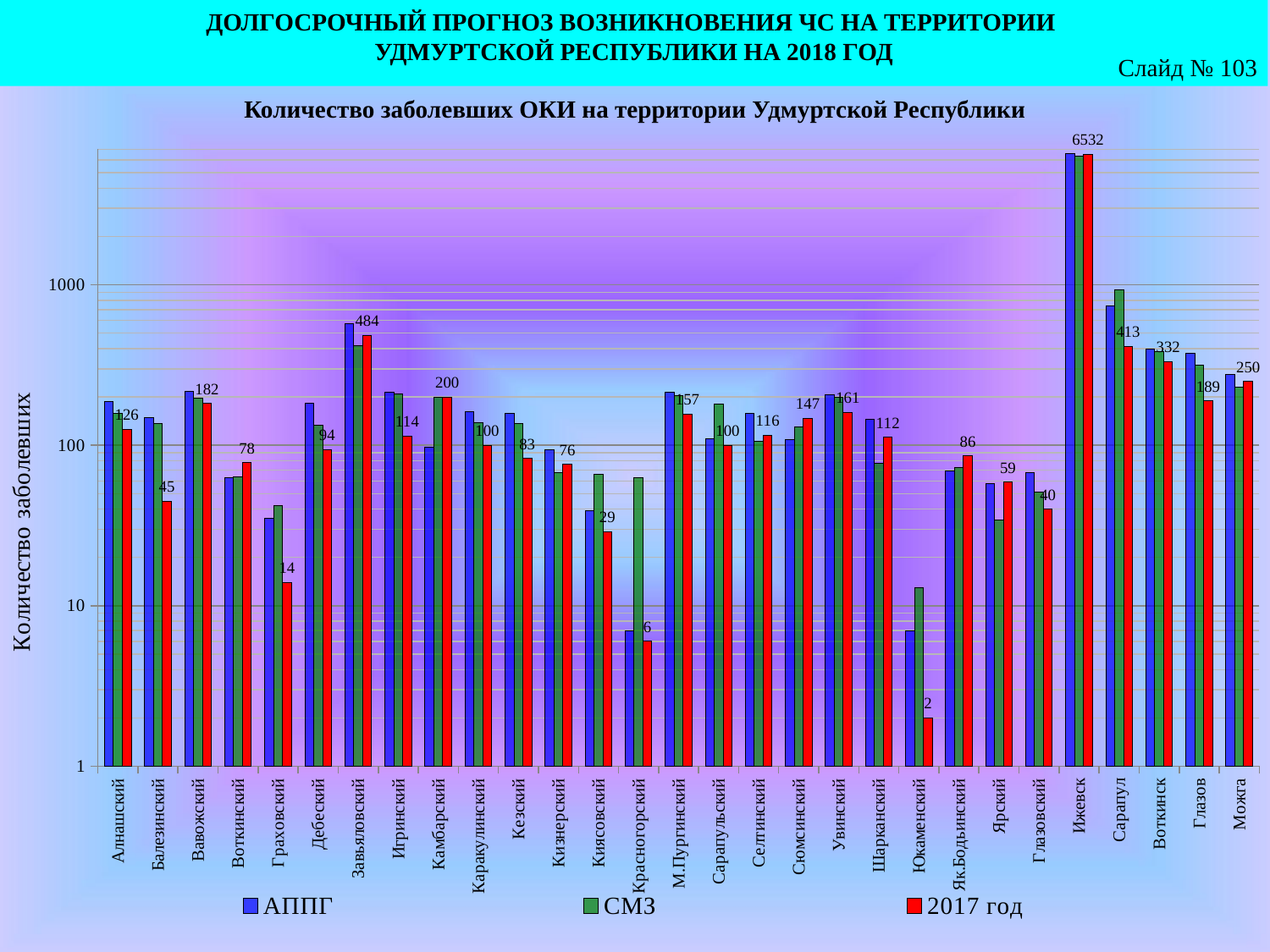
What is the value for Граховский in the 2017 год series? 14 How many categories (districts and cities) are shown on the x axis? 29 Which category has the lowest value in the 2017 год series? Юкаменский What is the title of the chart? Количество заболевших ОКИ на территории Удмуртской Республики What type of chart is shown on the slide? bar chart Which category has the highest value in the 2017 год series? Ижевск Which is larger in the 2017 год series: Камбарский or Увинский? Камбарский What is the difference between the 2017 год values for Сарапул and Воткинск? 81 Is the АППГ value for Ижевск greater or less than 1000? greater What is the value for Ижевск in the 2017 год series? 6532 How many series does the legend list? 3 What is the value for Завьяловский in the 2017 год series? 484